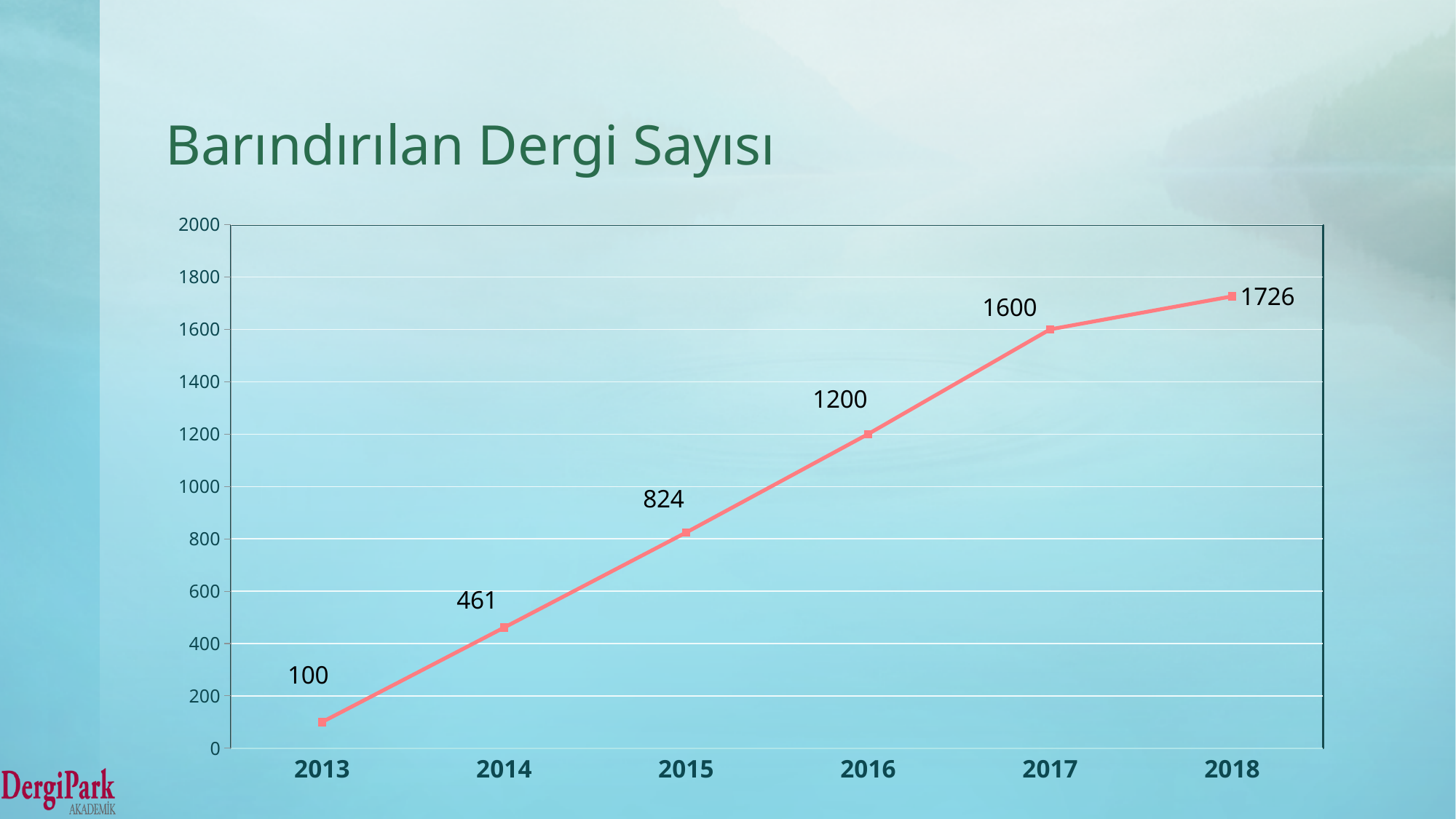
What is the value for 2018? 1726 Which year has the lowest value? 2013 What is the value for 2015? 824 What is the value for 2013? 100 What is the difference between the values for 2017 and 2016? 400 Which year has the highest value? 2018 How many years are plotted on the chart? 6 What kind of chart is shown on the slide? line chart Which is larger, the value for 2014 or the value for 2015? 2015 What is the difference between the values for 2018 and 2013? 1626 Do the values rise or fall from 2013 to 2018? rise Is the value for 2016 greater or less than 1000? greater